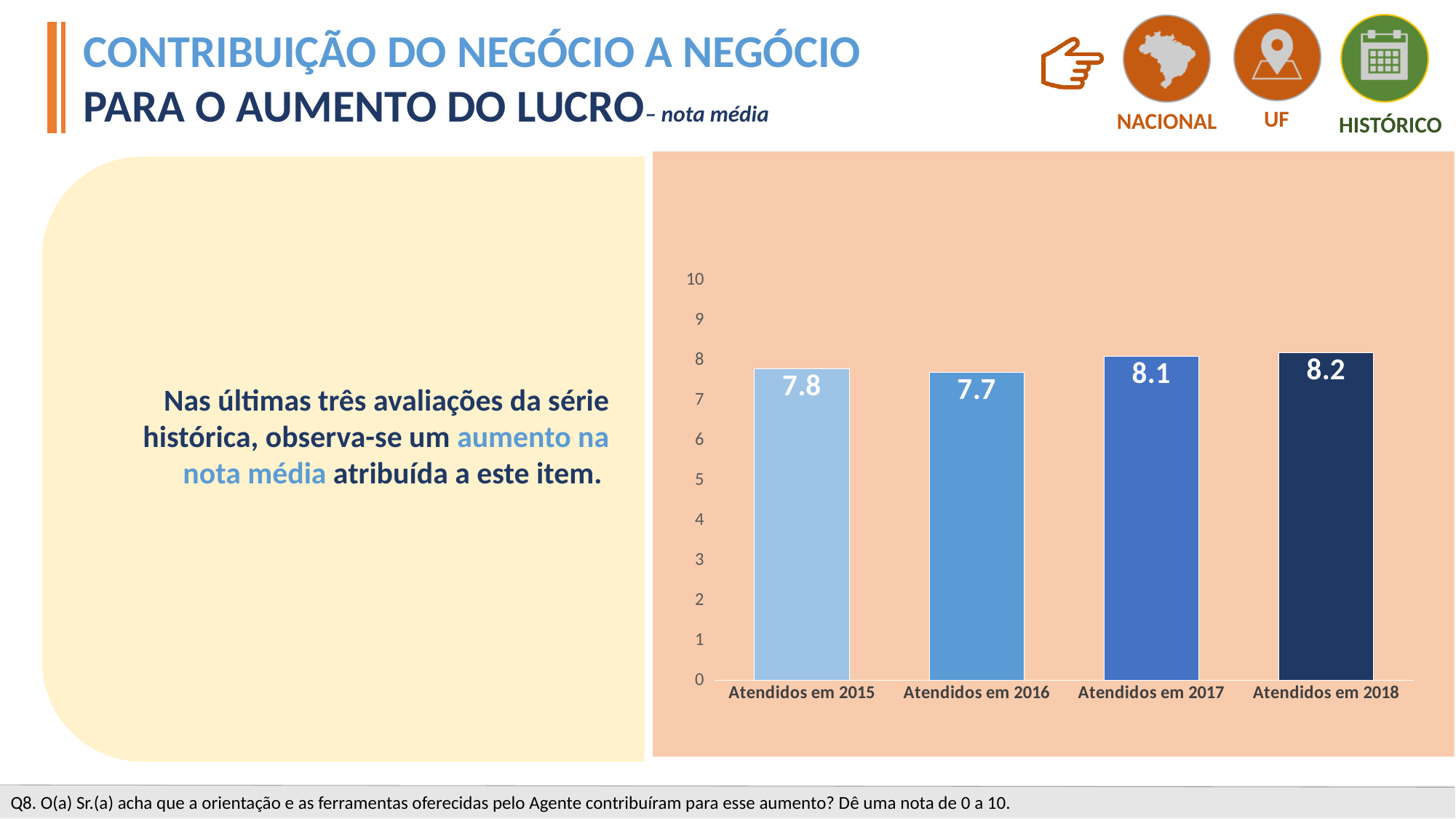
What kind of chart is shown on the slide? bar chart What is the value for Atendidos em 2016? 7.7 What is the difference between the values for Atendidos em 2018 and Atendidos em 2015? 0.4 Is the value for Atendidos em 2018 greater or less than 8? greater Which is larger, the value for Atendidos em 2017 or Atendidos em 2016? Atendidos em 2017 What is the value for Atendidos em 2015? 7.8 Do the values rise or fall from Atendidos em 2016 to Atendidos em 2018? rise How many categories are shown on the x axis? 4 What is the value for Atendidos em 2017? 8.1 Which category has the lowest value? Atendidos em 2016 What is the value for Atendidos em 2018? 8.2 Which category has the highest value? Atendidos em 2018